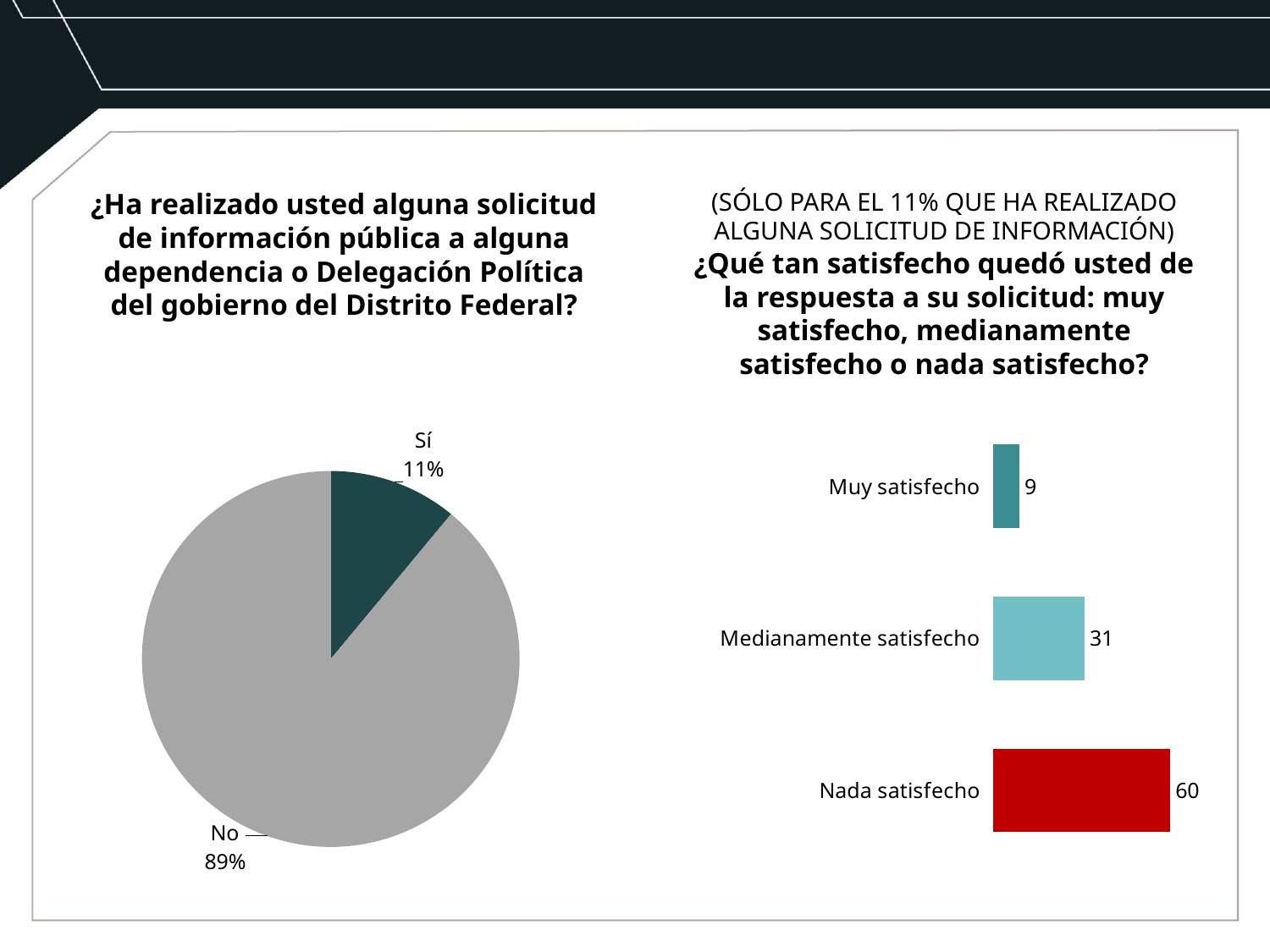
What kind of chart is the chart on the right of the slide? Bar chart In the bar chart on the right, which category has the highest value? Nada satisfecho In the bar chart on the right, what is the value for "Muy satisfecho"? 9 In the pie chart on the left, which answer has the larger slice, "Sí" or "No"? No In the pie chart on the left, what share of respondents answered "No"? 89% In the bar chart on the right, what is the value for "Medianamente satisfecho"? 31 In the bar chart on the right, what is the difference between the values for "Nada satisfecho" and "Medianamente satisfecho"? 29 In the bar chart on the right, what is the value for "Nada satisfecho"? 60 How many slices does the pie chart on the left have? 2 In the bar chart on the right, which category has the lowest value? Muy satisfecho In the pie chart on the left, what share of respondents answered "Sí"? 11% What kind of chart is the chart on the left of the slide? Pie chart